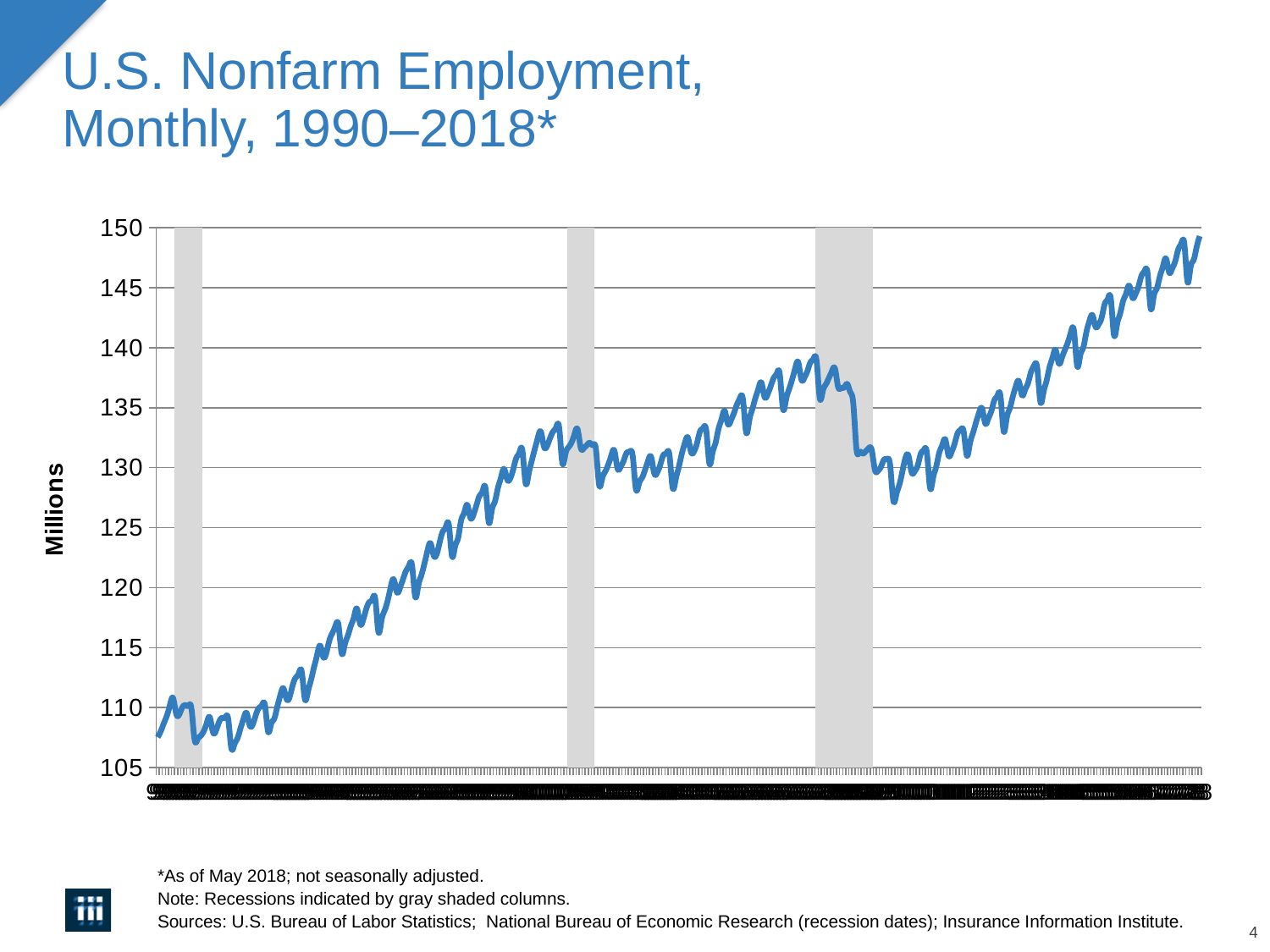
What kind of chart is shown on the slide? line chart Is the value at the far left start of the line greater or less than 110? less Overall, do the values rise or fall from the left to the right of the chart? rise What is the highest value shown on the vertical axis? 150 Is the value at the far right end of the line greater or less than the value at the far left start of the line? greater What is the title of the chart on the slide? U.S. Nonfarm Employment, Monthly, 1990–2018* Where along the chart does the line reach its highest value: near the left end, in the middle, or near the right end? near the right end Is the lowest point reached just after the third gray shaded column greater or less than 130? less Is the peak reached just before the third gray shaded column greater or less than 140? less What is the label on the vertical axis of the chart? Millions